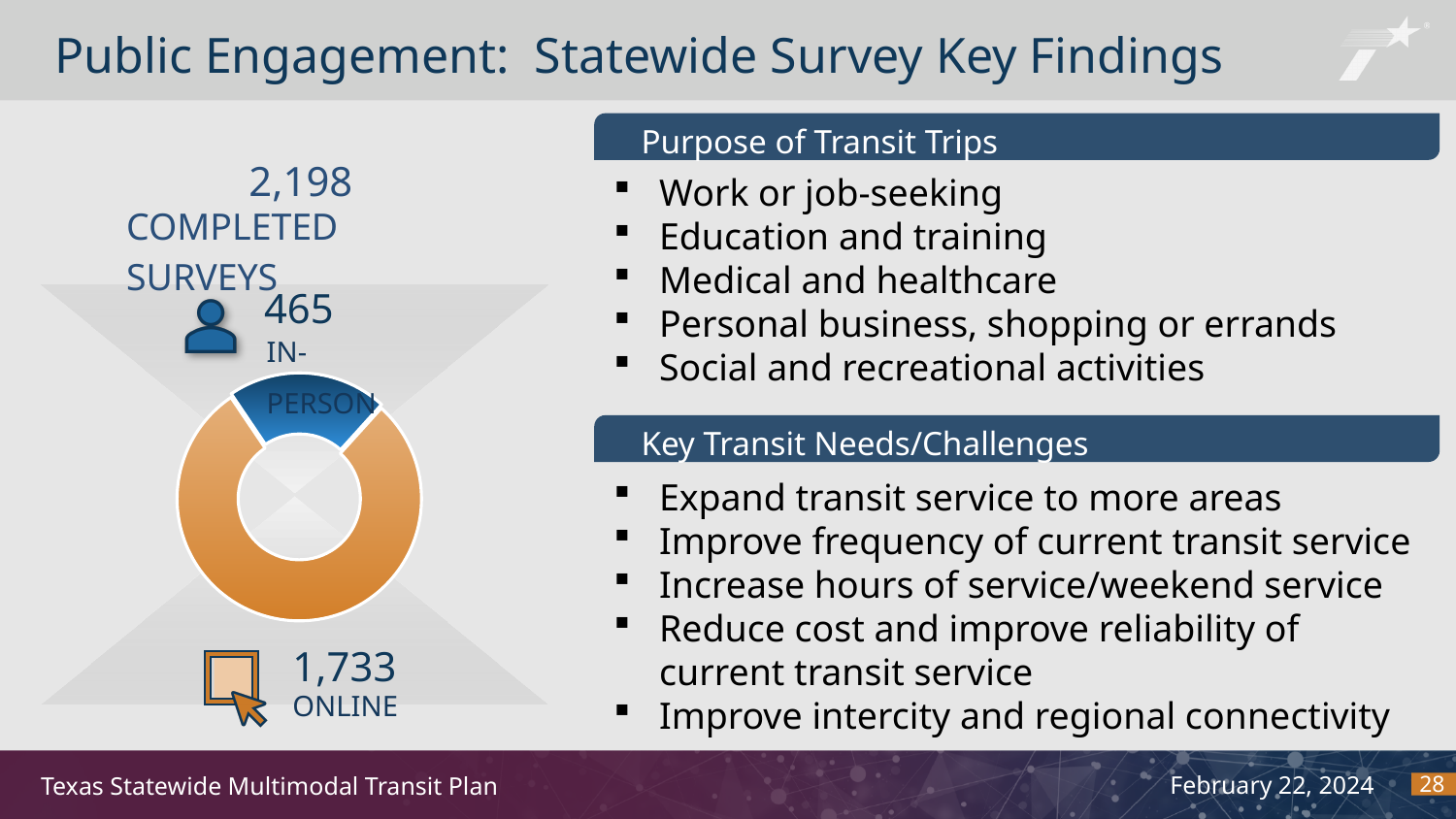
How many categories does the donut chart show? 2 What is the difference between the number of online surveys and in-person surveys? 1,268 Which survey method accounts for the smaller segment of the donut chart? In-person How many surveys were completed in-person according to the donut chart? 465 How many surveys were completed online according to the donut chart? 1,733 What kind of chart is used to show the split between in-person and online surveys? Donut (pie) chart What is the total number of completed surveys shown on the slide? 2,198 What colour is the in-person segment of the donut chart? Blue What colour is the online segment of the donut chart? Orange Were more surveys completed online or in-person? Online Which survey method accounts for the larger segment of the donut chart? Online